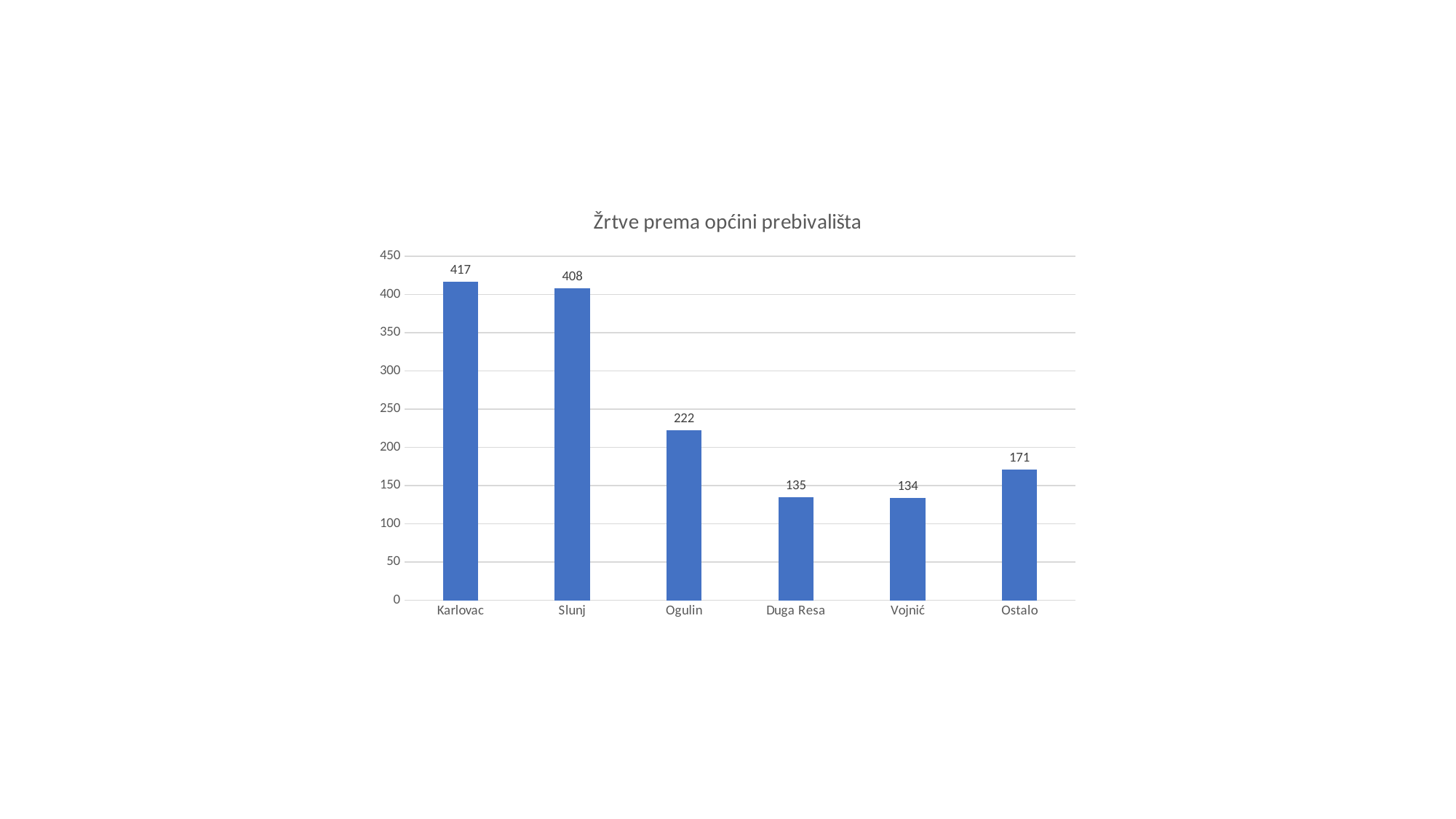
What is the difference between the values for Ogulin and Ostalo? 51 What is the value for Ostalo? 171 What is the value for Ogulin? 222 What is the value for Karlovac? 417 Is the value for Slunj greater or less than 400? greater What kind of chart is shown on the slide? bar chart What is the title of the chart? Žrtve prema općini prebivališta How many categories are shown on the x axis? 6 What is the difference between the values for Karlovac and Slunj? 9 Which is larger, the value for Ogulin or the value for Ostalo? Ogulin Which category has the highest value? Karlovac Which category has the lowest value? Vojnić